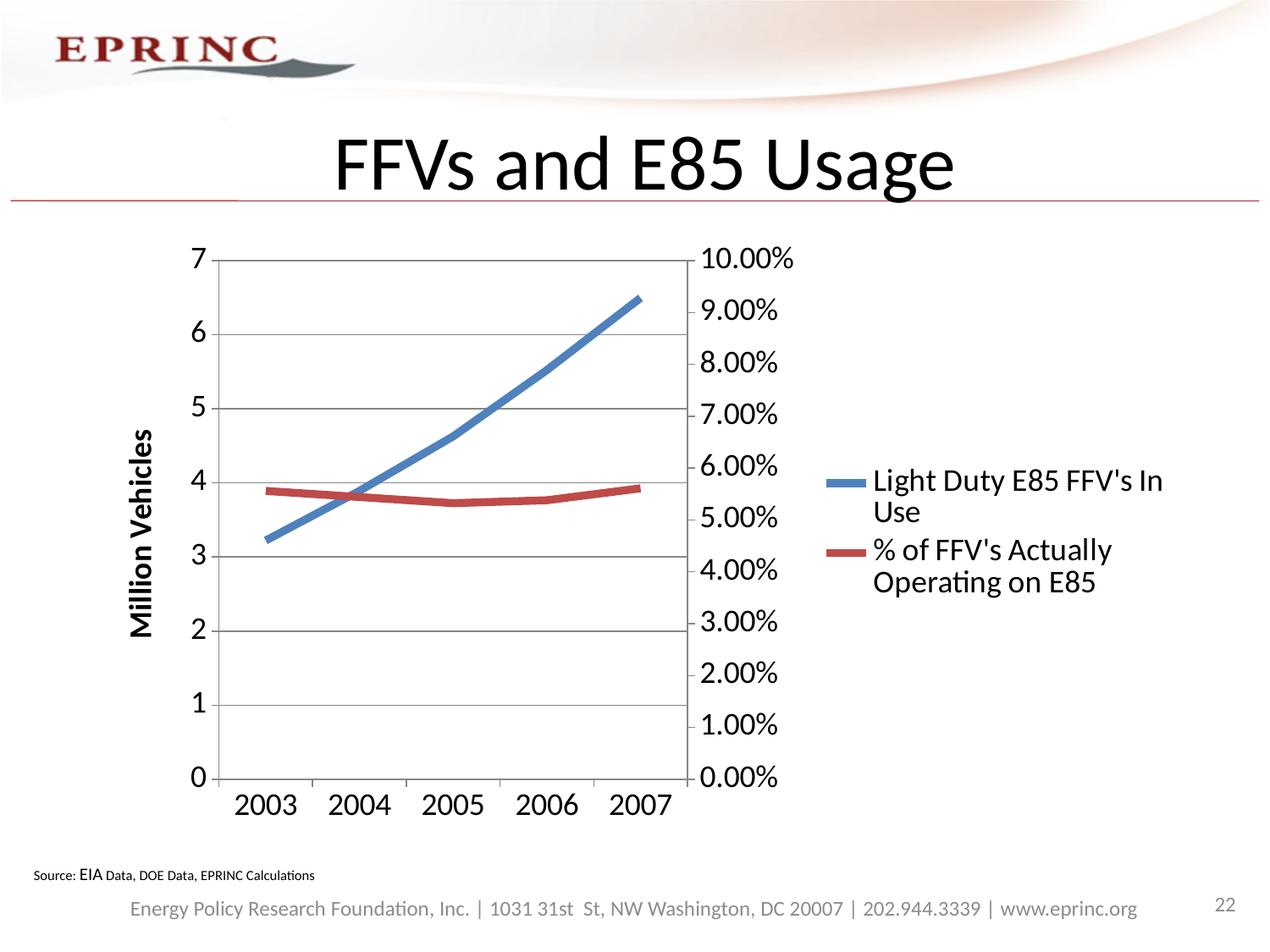
Is the % of FFV's Actually Operating on E85 value for 2007 greater or less than 6.00%? less Which is larger, the Light Duty E85 FFV's In Use value for 2007 or for 2004? 2007 Does the Light Duty E85 FFV's In Use line rise or fall from 2003 to 2007? rise Is the Light Duty E85 FFV's In Use value for 2007 greater or less than 6 million vehicles? greater Is the Light Duty E85 FFV's In Use value for 2003 greater or less than 4 million vehicles? less What is the label on the left vertical axis? Million Vehicles In which year is the Light Duty E85 FFV's In Use value highest? 2007 In which year is the Light Duty E85 FFV's In Use value lowest? 2003 What kind of chart is shown on the slide? line chart What is the title of the chart? FFVs and E85 Usage How many series does the legend list? 2 How many years are plotted along the x axis? 5